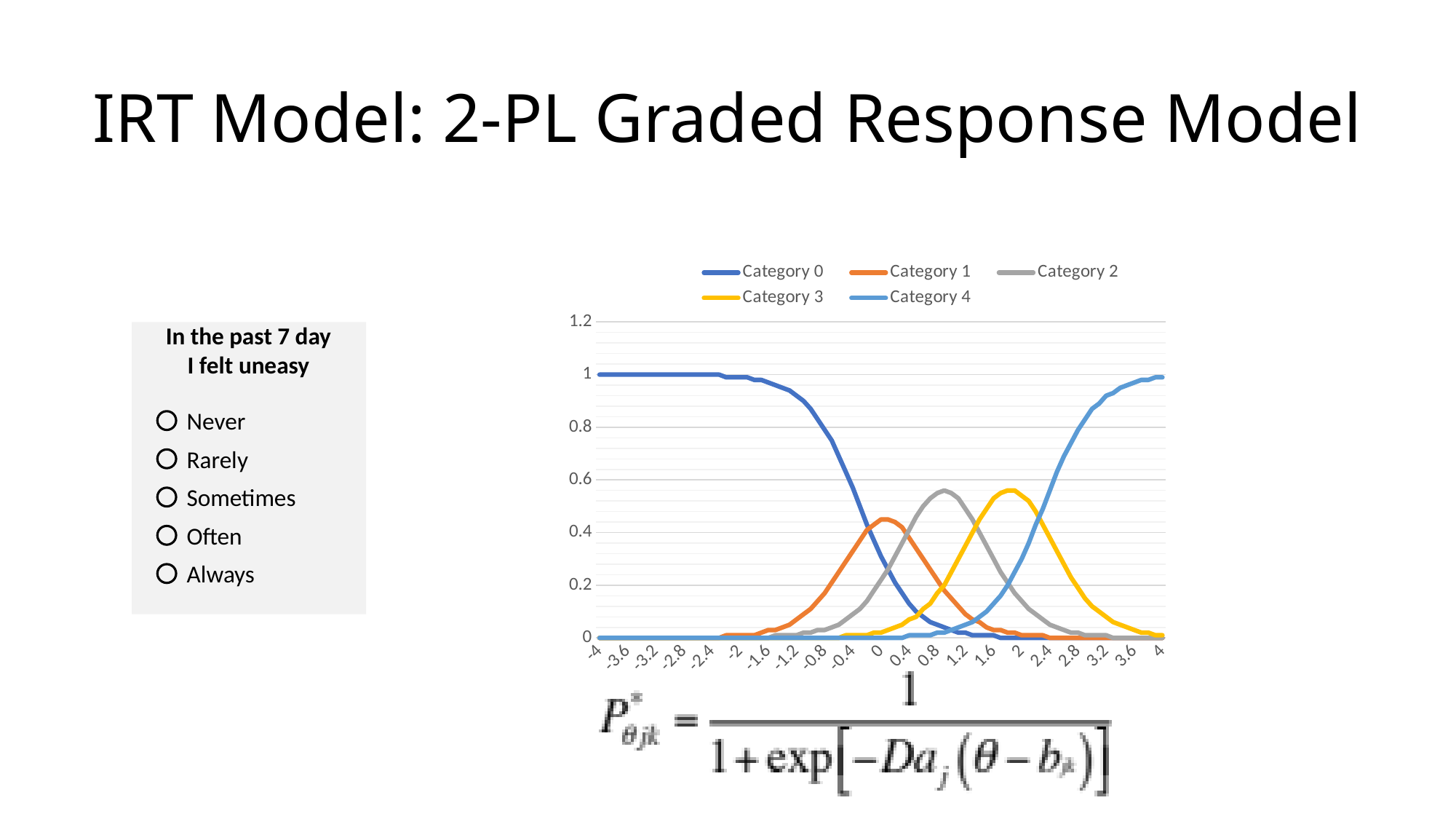
Does the Category 0 line rise or fall as the x axis increases? fall Is the value of Category 4 at x = 0 greater or less than 0.2? less Which series has the highest value at x = 0? Category 1 Which series has the highest value at x = -4? Category 0 How many series does the chart legend list? 5 What kind of chart is shown on the slide? line chart What are the series names listed in the chart legend? Category 0, Category 1, Category 2, Category 3, Category 4 Does the Category 4 line rise or fall as the x axis increases? rise What colour is the Category 3 line in the chart? yellow Is the peak value of the Category 1 line greater or less than 0.6? less Is the value of Category 0 at x = -2 greater or less than 0.8? greater Which line reaches a higher peak, Category 1 or Category 3? Category 3